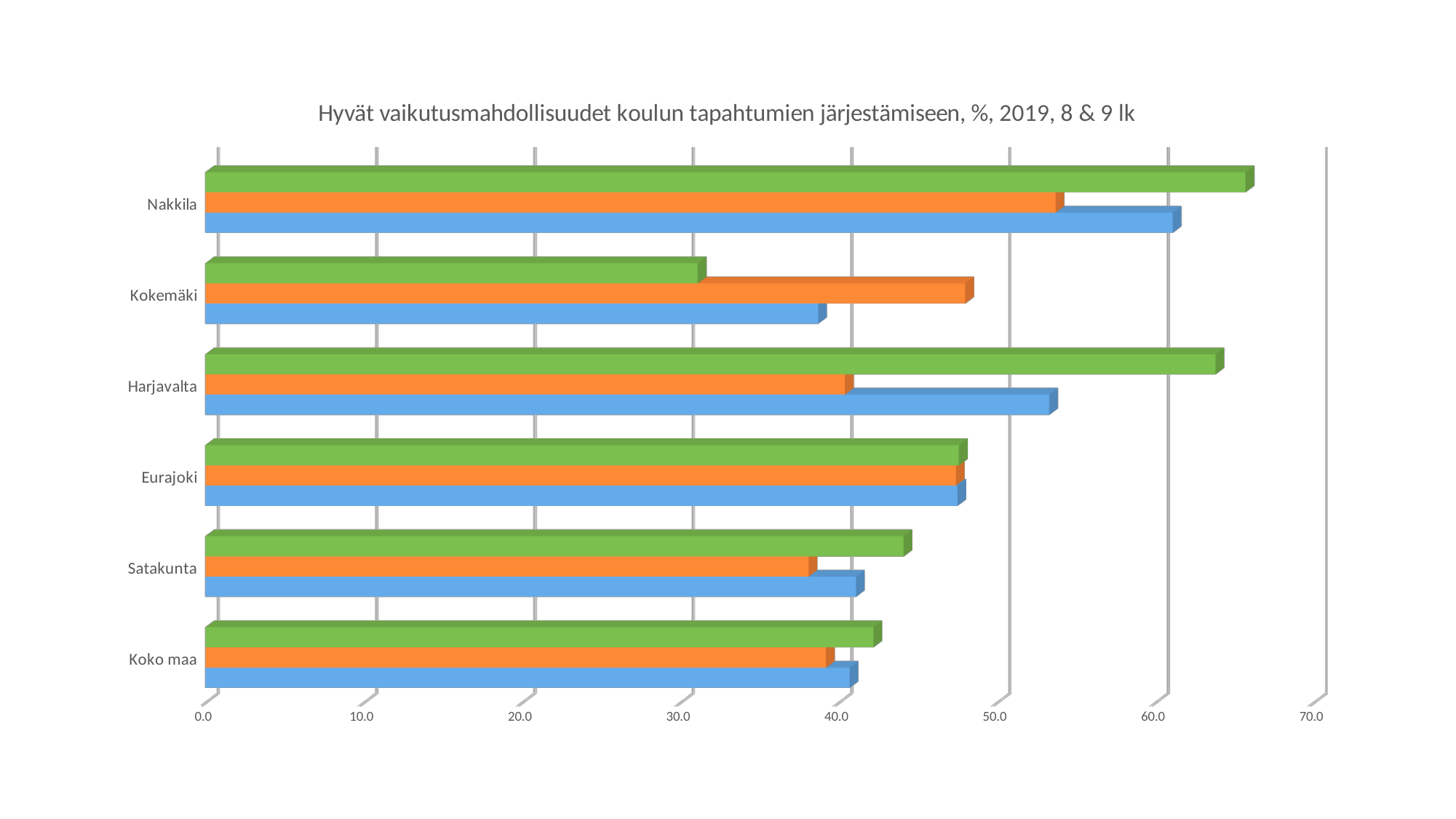
Which category has the longest orange bar? Nakkila Is the blue bar for Harjavalta greater or less than 50.0? greater What kind of chart is shown on the slide? bar chart Is the green bar for Nakkila greater or less than 60.0? greater For Kokemäki, which is larger: the orange bar or the green bar? the orange bar How many categories are shown on the vertical axis of the chart? 6 What is the highest value shown on the horizontal axis of the chart? 70.0 Which category has the shortest green bar? Kokemäki Is the green bar for Kokemäki greater or less than 40.0? less Which category has the longest blue bar? Nakkila What is the title of the chart? Hyvät vaikutusmahdollisuudet koulun tapahtumien järjestämiseen, %, 2019, 8 & 9 lk Which category has the longest green bar? Nakkila